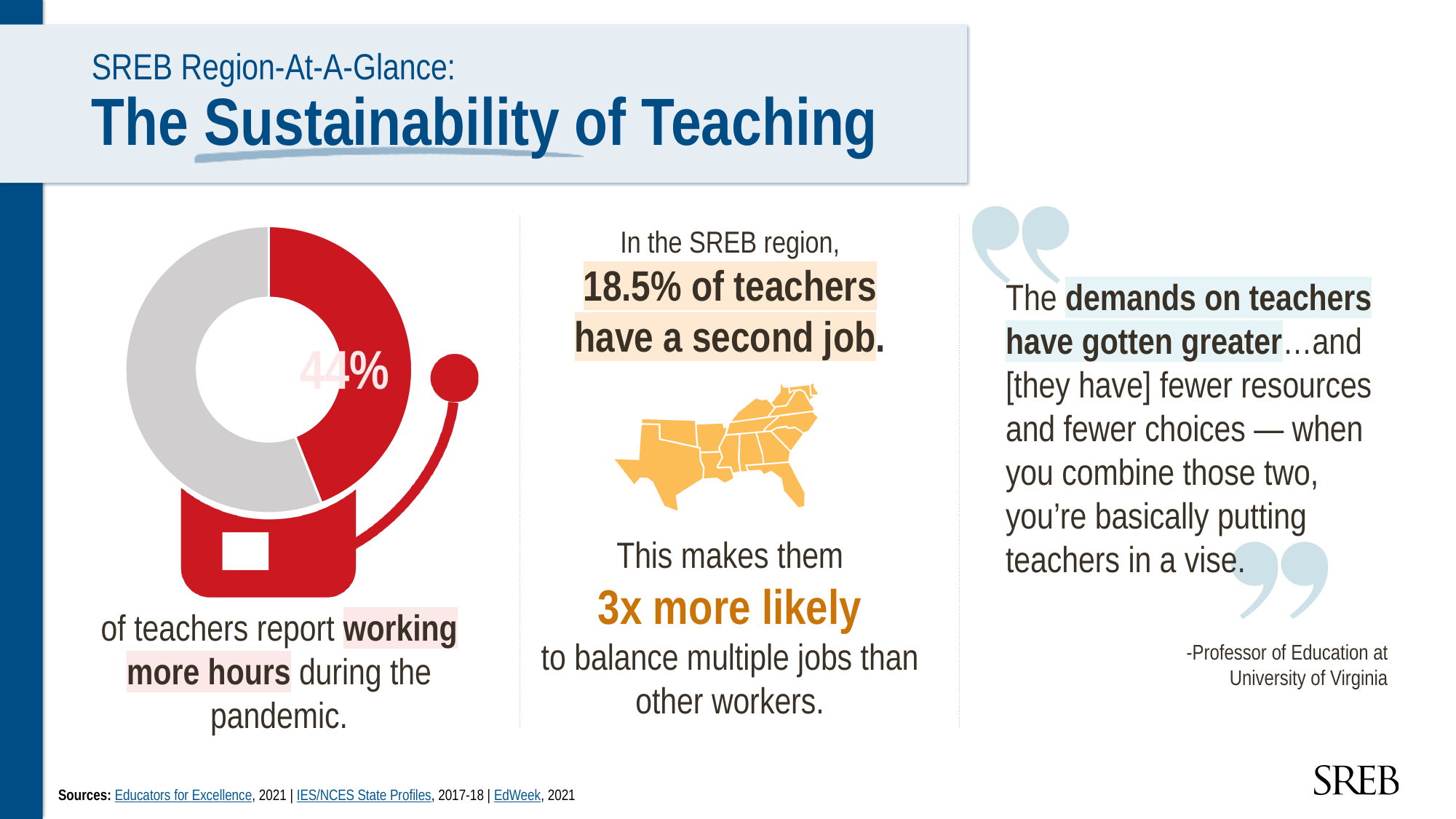
Is the red slice of the donut chart greater or less than 50% of the whole? less What percentage is labeled on the donut chart? 44% How many slices does the donut chart have? 2 Which slice of the donut chart is larger, the red slice or the gray slice? Gray According to the donut chart, what do 44% of teachers report? Working more hours during the pandemic What colour is the slice of the donut chart labeled 44%? Red What kind of chart is shown on the left of the slide? Donut chart What share of teachers does the red slice of the donut chart represent? 44%